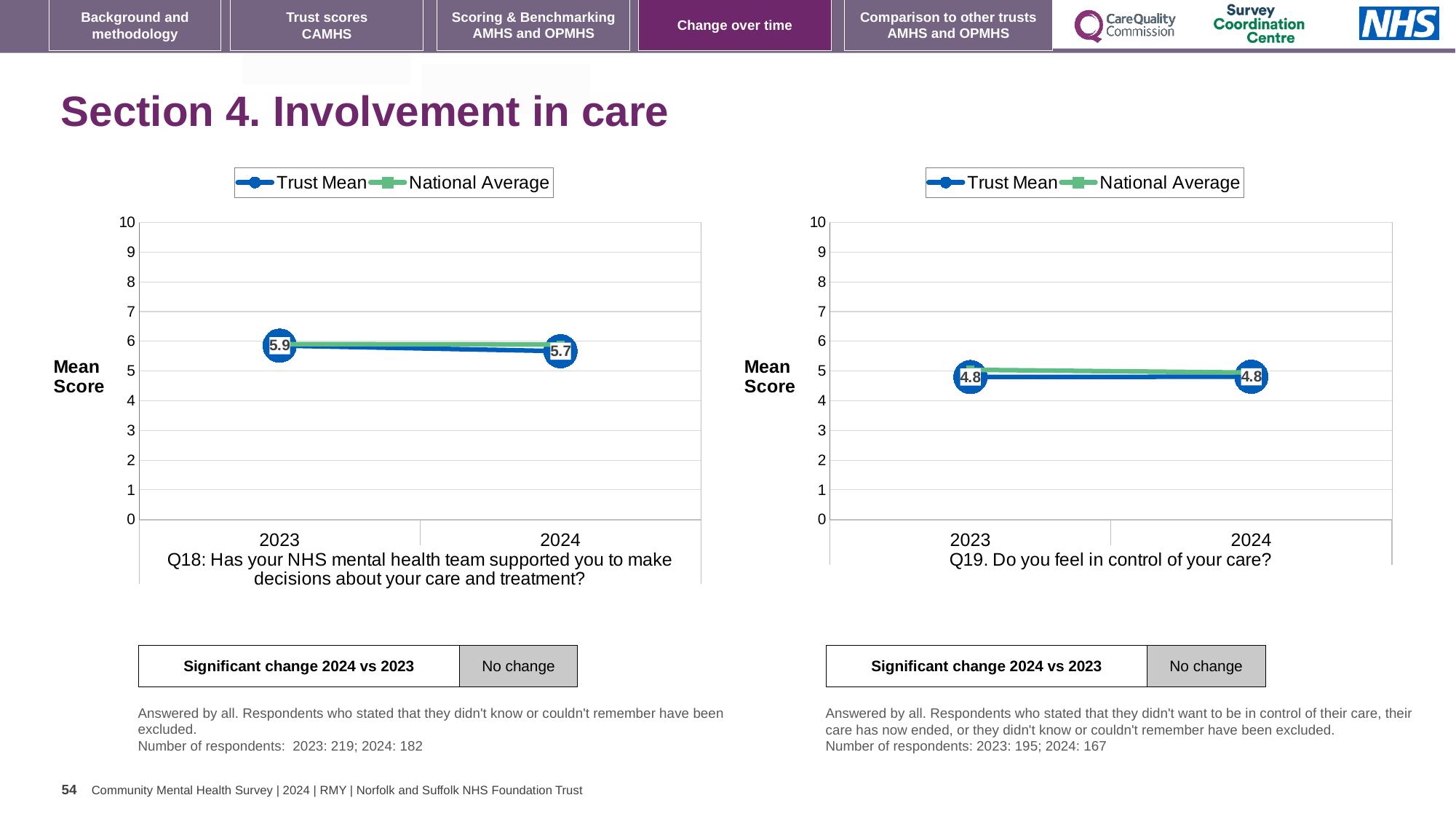
In the Q18 chart on the left, what is the Trust Mean score for 2024? 5.7 In the Q18 chart on the left, what is the Trust Mean score for 2023? 5.9 What is the label on the y axis of the Q18 chart on the left? Mean Score How many years are plotted on the x axis of the Q19 chart on the right? 2 In the Q18 chart on the left, does the Trust Mean rise or fall from 2023 to 2024? fall How many series does the legend of the Q18 chart on the left list? 2 In the Q18 chart on the left, is the Trust Mean for 2023 greater or less than 5? greater In the Q19 chart on the right, what is the Trust Mean score for 2024? 4.8 In the Q18 chart on the left, by how much did the Trust Mean change from 2023 to 2024? 0.2 In the Q19 chart on the right, does the Trust Mean rise, fall or stay the same from 2023 to 2024? stay the same What type of chart is the Q19 chart on the right? line chart In the Q19 chart on the right, is the Trust Mean for 2023 greater or less than 5? less